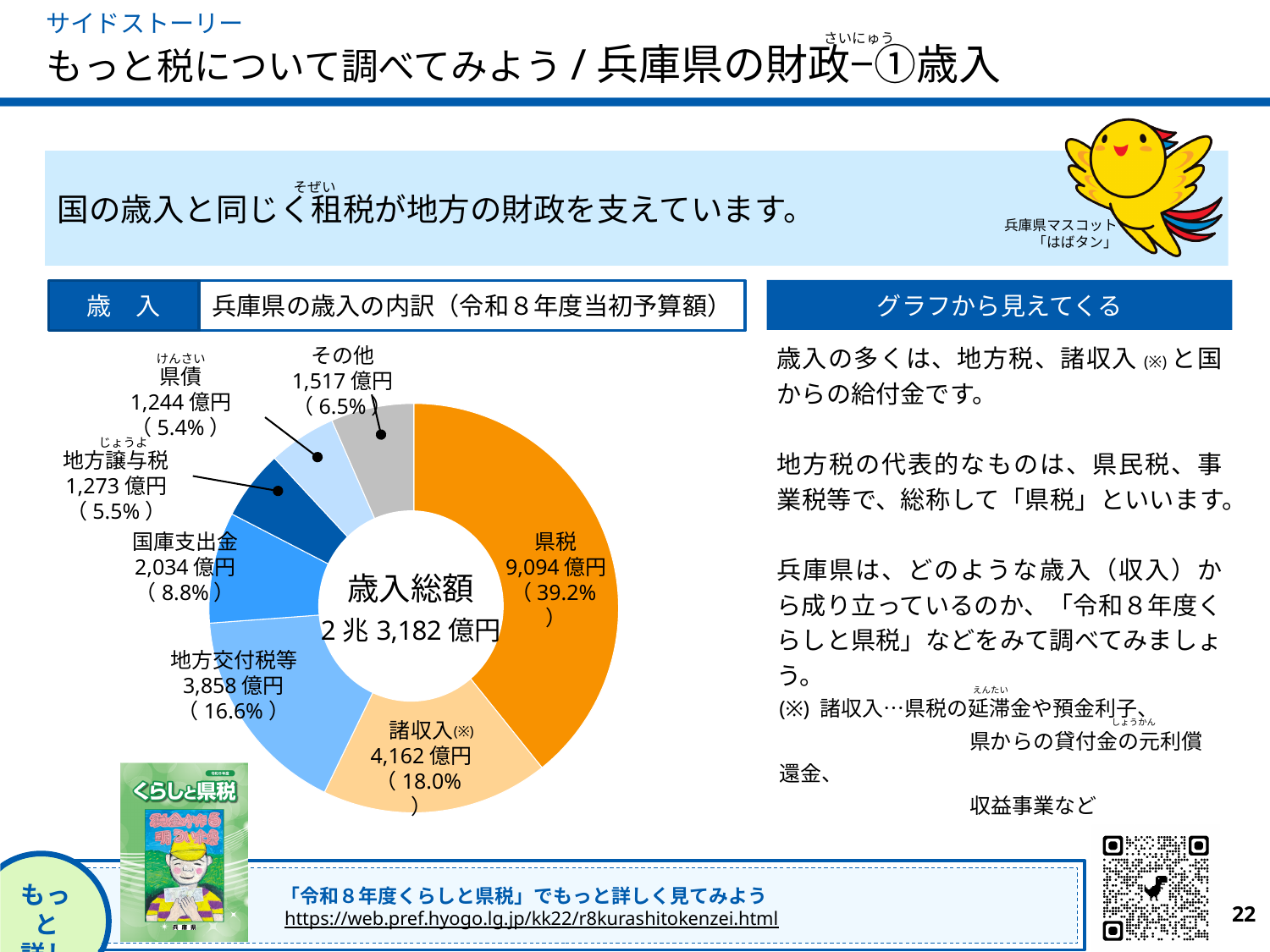
円グラフで、諸収入の歳入額はいくらですか。 4,162億円 円グラフのタイトルは何ですか。 兵庫県の歳入の内訳（令和８年度当初予算額） 円グラフには、歳入の項目がいくつ示されていますか。 7 このスライドのグラフはどのような種類のグラフですか。 円グラフ（ドーナツグラフ） 円グラフで、県税の歳入額はいくらですか。 9,094億円 円グラフで、歳入額が最も大きい項目はどれですか。 県税 円グラフで、県税は歳入全体の何%を占めていますか。 39.2% 円グラフの中央に示されている歳入総額はいくらですか。 2兆3,182億円 円グラフで、地方交付税等と国庫支出金では、どちらの歳入額が大きいですか。 地方交付税等 円グラフで、県税と諸収入の歳入額の差はいくらですか。 4,932億円 円グラフで、歳入額が最も小さい項目はどれですか。 県債 円グラフで、地方交付税等の割合は何%ですか。 16.6%